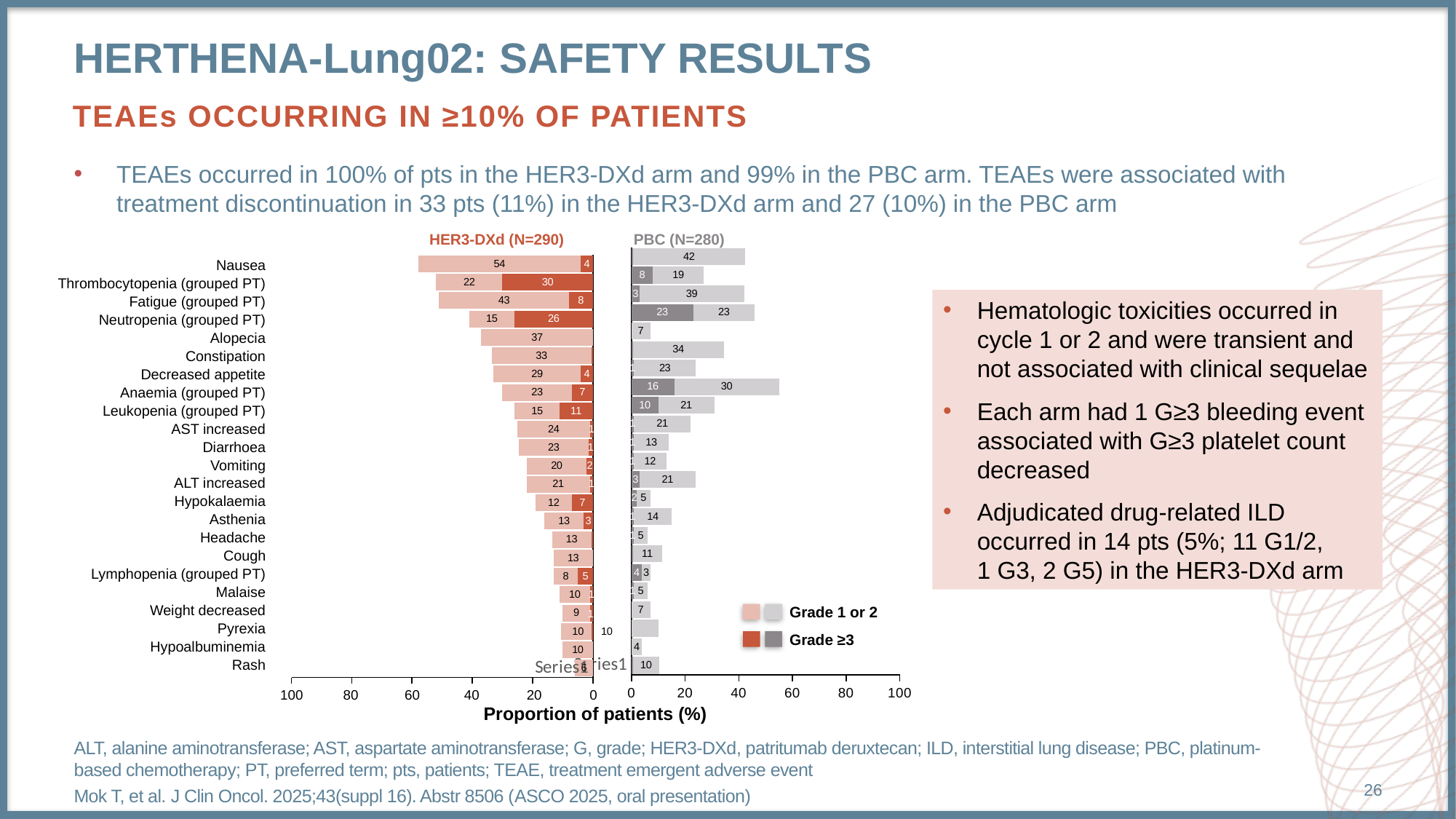
In the PBC (N=280) chart, what is the total proportion of patients with Anaemia (grouped PT) across both grade groups? 46 In the HER3-DXd (N=290) chart, what is the Grade 1 or 2 value for Nausea? 54 How many series does the legend list? 2 Is the Grade 1 or 2 value for Alopecia larger in the HER3-DXd (N=290) chart or the PBC (N=280) chart? HER3-DXd (N=290) In the HER3-DXd (N=290) chart, what is the difference between the Grade ≥3 values for Thrombocytopenia (grouped PT) and Neutropenia (grouped PT)? 4 In the HER3-DXd (N=290) chart, what is the total proportion of patients with Neutropenia (grouped PT) across both grade groups? 41 In the HER3-DXd (N=290) chart, what is the Grade ≥3 value for Thrombocytopenia (grouped PT)? 30 How many adverse event categories are listed on the y axis of the charts? 23 In the HER3-DXd (N=290) chart, which adverse event has the highest Grade ≥3 value? Thrombocytopenia (grouped PT) In the PBC (N=280) chart, which adverse event has the highest Grade 1 or 2 value? Nausea In the PBC (N=280) chart, what is the Grade ≥3 value for Neutropenia (grouped PT)? 23 In the PBC (N=280) chart, what is the Grade 1 or 2 value for Constipation? 34